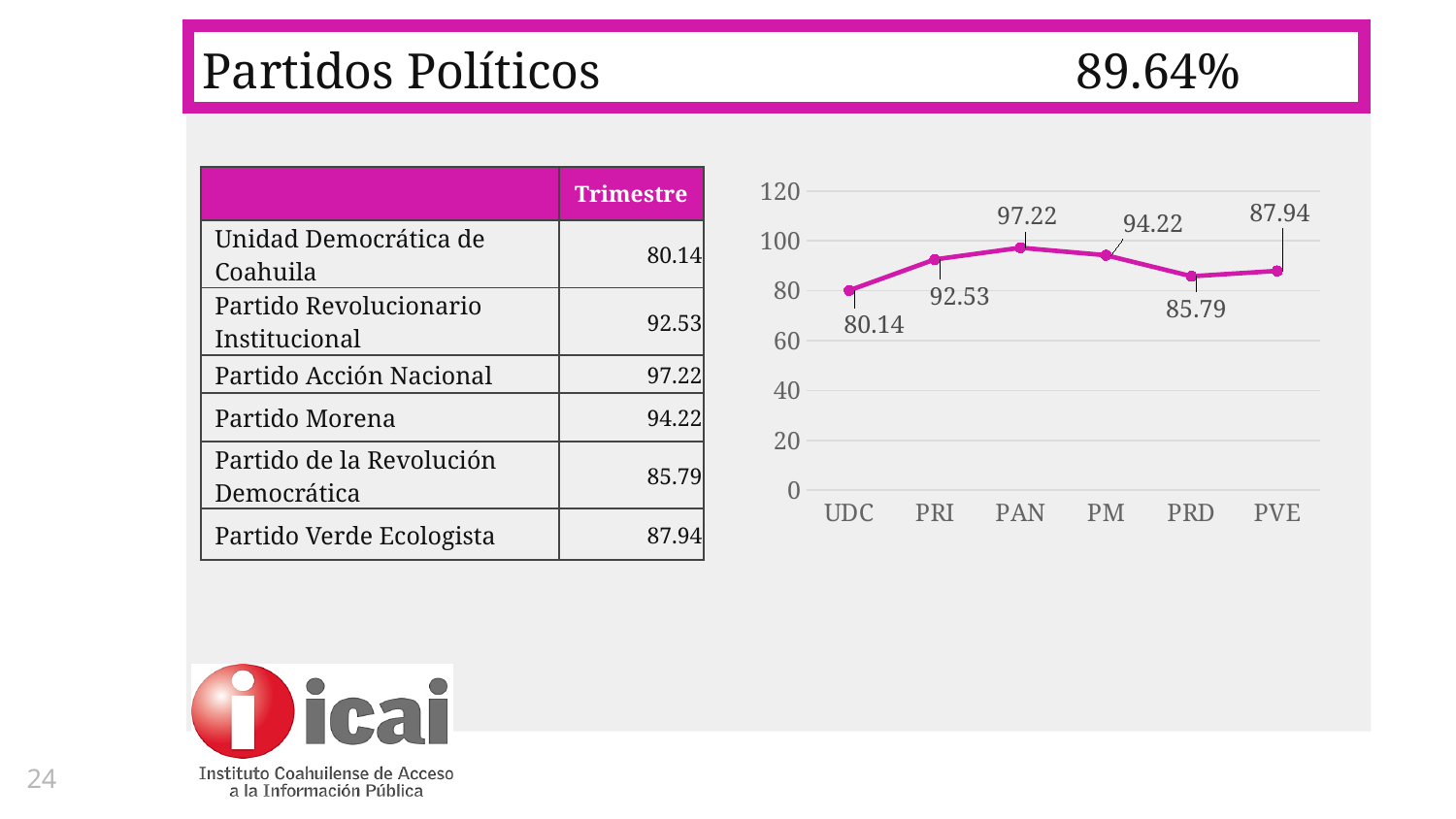
How many categories are plotted on the x axis of the line chart? 6 What kind of chart is shown on the slide? line chart What is the maximum value shown on the y axis of the line chart? 120 Does the line rise or fall from UDC to PAN in the line chart? rise What is the difference between the values for PAN and UDC in the line chart? 17.08 What is the value for PRD in the line chart? 85.79 Which category has the lowest value in the line chart? UDC Which category has the highest value in the line chart? PAN What is the value for PAN in the line chart? 97.22 Is the value for PM in the line chart greater or less than 80? greater What is the value for UDC in the line chart? 80.14 Which has a larger value in the line chart, PRI or PVE? PRI